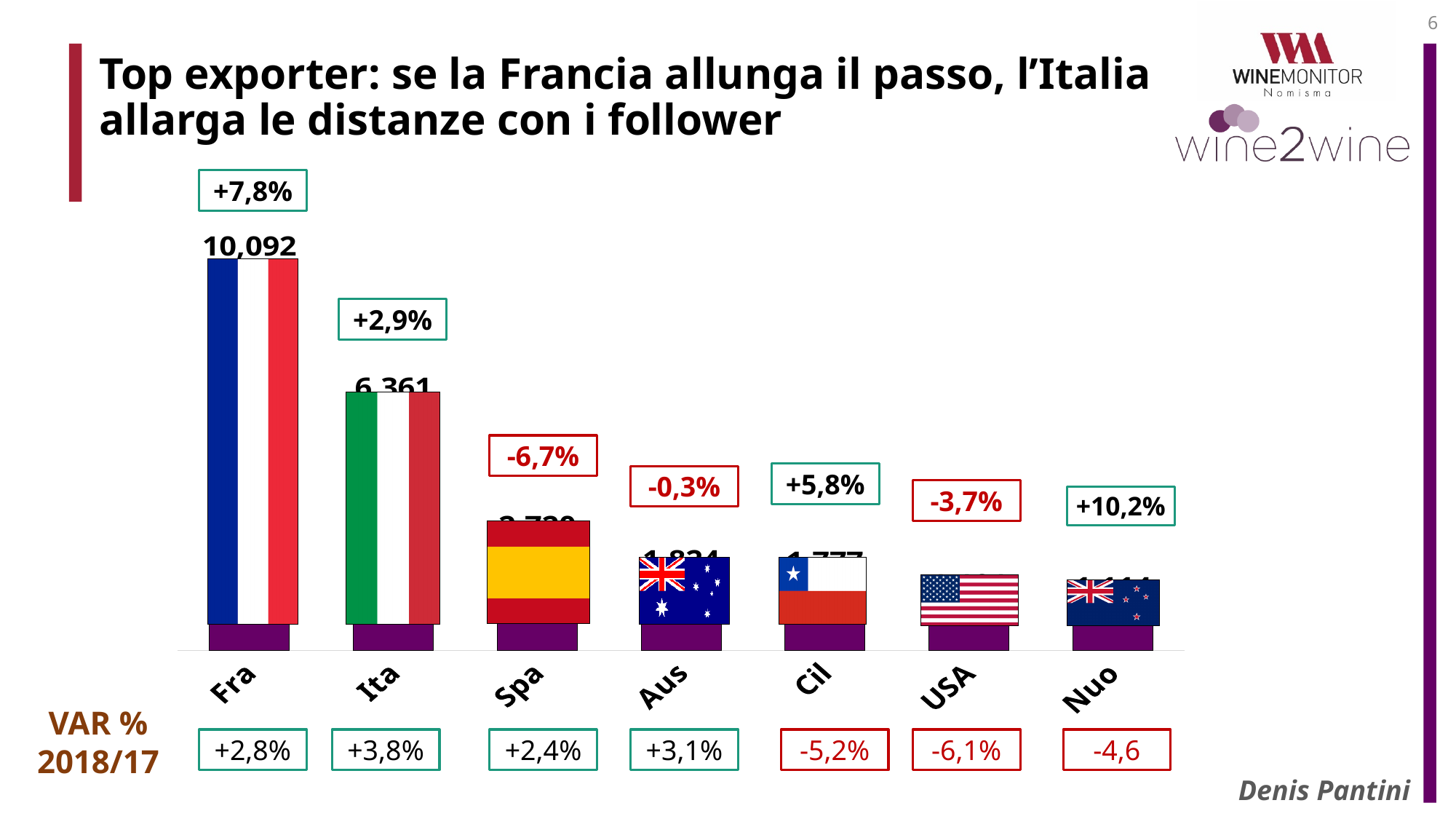
What is the VAR % 2018/17 value shown below USA? -6,1% What is the difference between the values for Fra and Ita? 3,731 What percentage is shown in the box above the Spa bar? -6,7% Which country has the lowest bar? Nuo What percentage is shown in the box above the Nuo bar? +10,2% How many countries are shown on the chart? 7 Which has a larger value, Spa or Aus? Spa What is the value shown for Fra? 10,092 What kind of chart is this? bar chart What is the value shown for Ita? 6,361 Which country has the highest bar? Fra Do the bar values rise or fall from left to right? fall